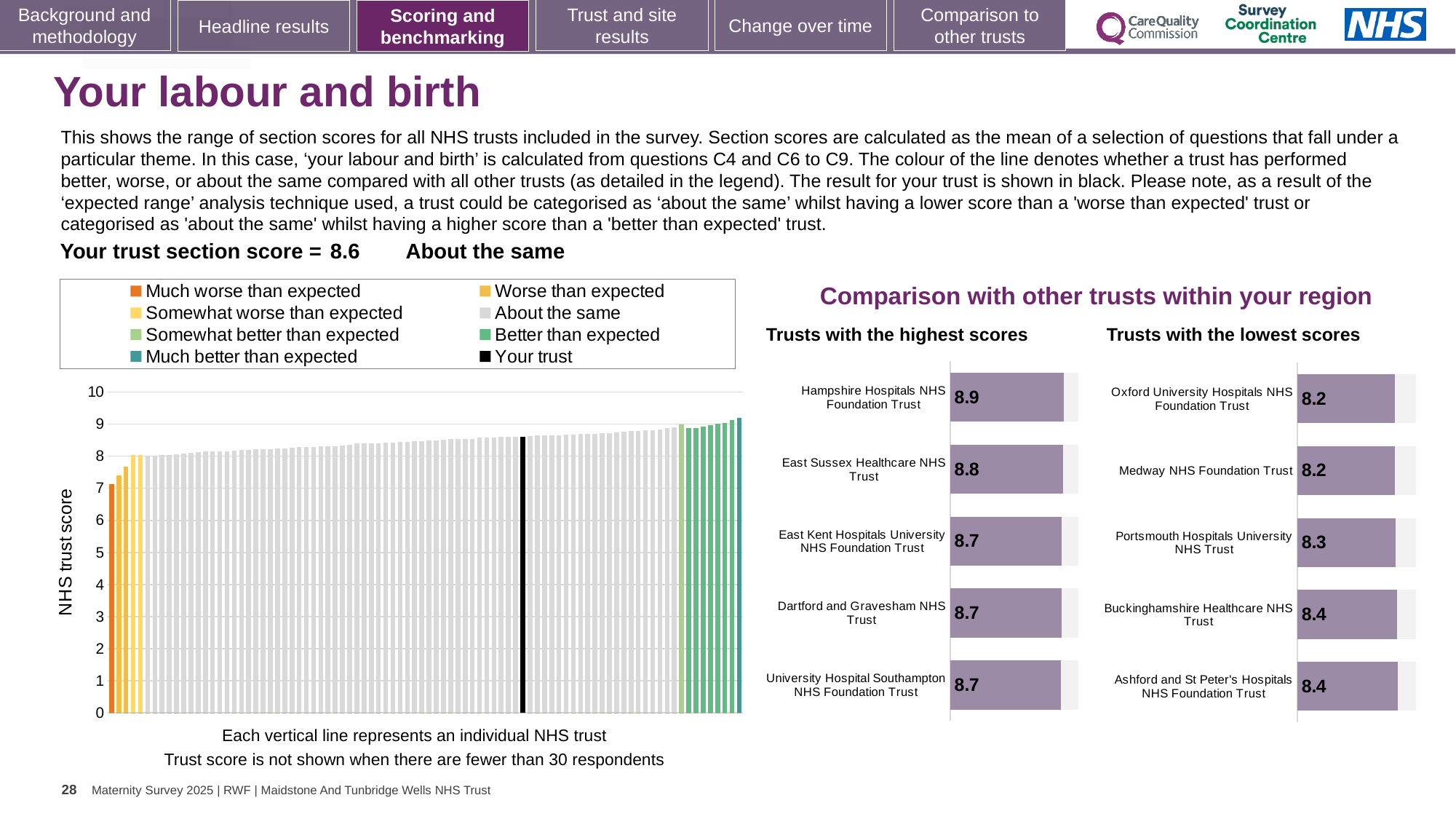
In the 'Trusts with the lowest scores' chart, what is the score for Medway NHS Foundation Trust? 8.2 In the 'Trusts with the lowest scores' chart, what is the difference between the scores of Ashford and St Peter's Hospitals NHS Foundation Trust and Oxford University Hospitals NHS Foundation Trust? 0.2 What is the y-axis label of the large chart on the left? NHS trust score In the 'Trusts with the lowest scores' chart, what is the score for Portsmouth Hospitals University NHS Trust? 8.3 In the 'Trusts with the highest scores' chart, what is the score for Hampshire Hospitals NHS Foundation Trust? 8.9 In the large chart on the left, is the value of the black bar (your trust) greater or less than 8? greater How many entries does the legend of the large chart on the left list? 8 In the 'Trusts with the highest scores' chart, what is the difference between the scores of Hampshire Hospitals NHS Foundation Trust and East Sussex Healthcare NHS Trust? 0.1 In the 'Trusts with the lowest scores' chart, which has the larger score: Portsmouth Hospitals University NHS Trust or Buckinghamshire Healthcare NHS Trust? Buckinghamshire Healthcare NHS Trust In the 'Trusts with the highest scores' chart, which trust has the highest score? Hampshire Hospitals NHS Foundation Trust What kind of chart is the large chart on the left showing all NHS trusts? bar chart In the 'Trusts with the highest scores' chart, how many trusts are listed? 5